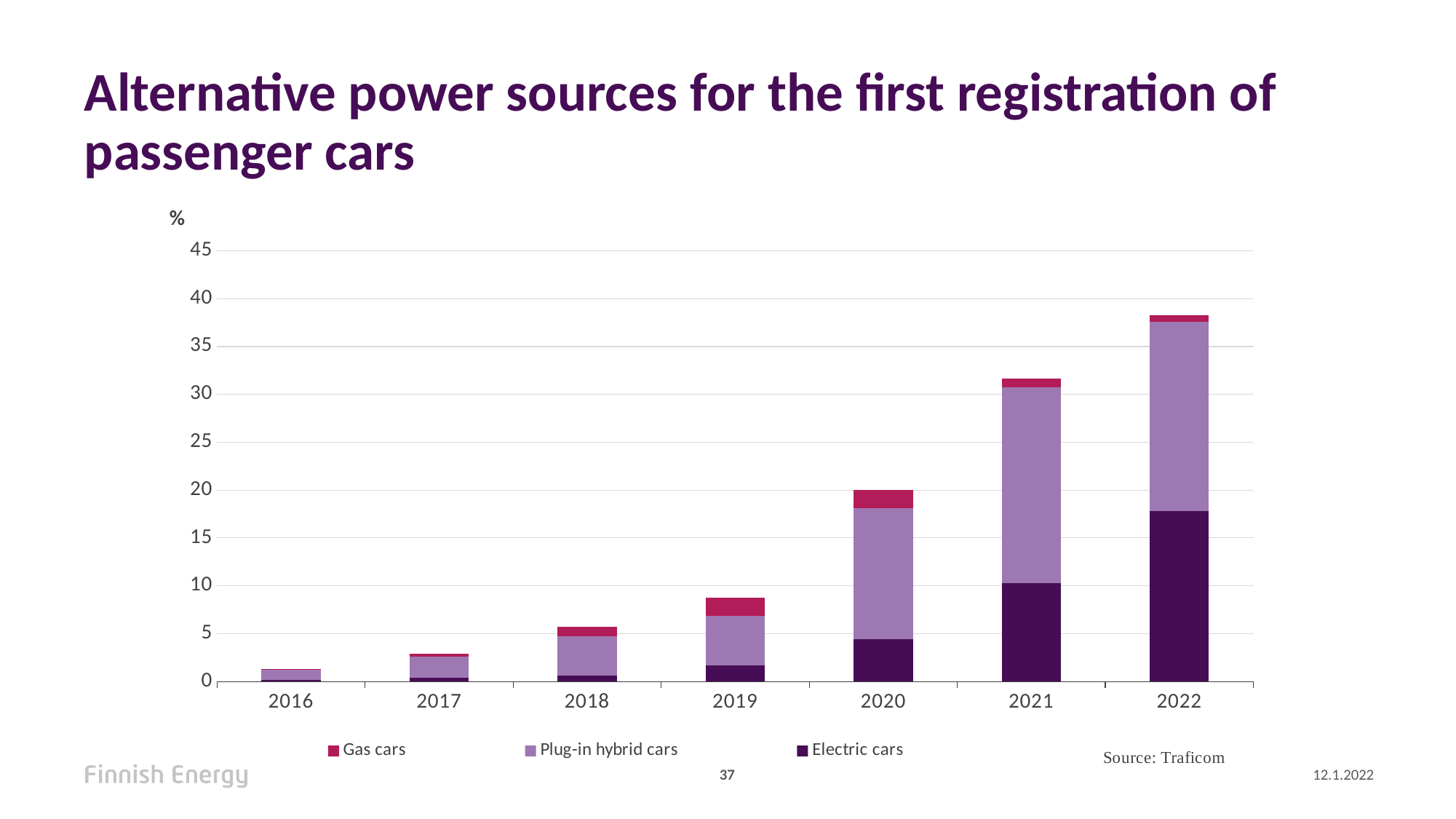
Which year has the tallest stacked bar in the chart? 2022 What unit is shown on the vertical axis of the chart? % Is the Electric cars value for 2021 greater or less than 5? greater How many years are shown on the x axis of the chart? 7 Do the total bar heights rise or fall from 2016 to 2022? Rise Which year has the shortest stacked bar in the chart? 2016 Is the total value for 2022 greater or less than 35? greater Is the Electric cars value for 2022 greater or less than 15? greater Which series is shown in the darkest purple colour in the chart? Electric cars What kind of chart is shown on the slide? Stacked bar chart How many series does the chart's legend list? 3